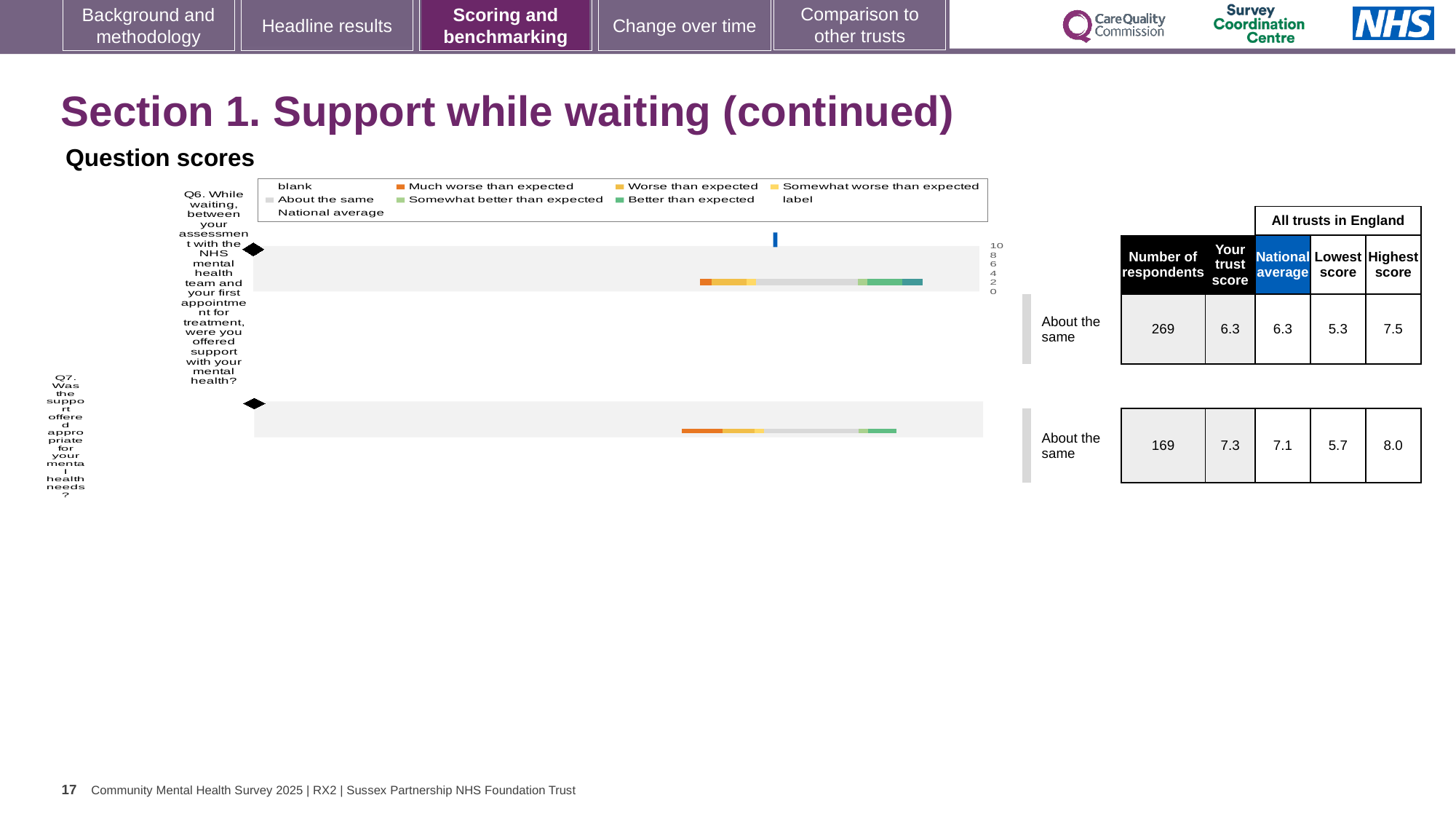
In the table next to the chart, which question has the higher 'Your trust score', Q6 or Q7? Q7 What is the highest tick value shown on the chart's score axis? 10 What kind of chart is shown under 'Question scores'? bar chart In the table next to the chart, what is the highest score across all trusts in England for Q7? 8.0 In the table next to the chart, what is the lowest score across all trusts in England for Q7? 5.7 In the table next to the chart, what is 'Your trust score' for Q7? 7.3 In the table next to the chart, what is the number of respondents for Q6? 269 In the table next to the chart, what is the national average for Q6? 6.3 How many entries does the chart legend list? 9 In the table next to the chart, what is the difference between the highest and lowest score for Q6? 2.2 How many questions (bars) are plotted in the chart? 2 What colour represents 'Much worse than expected' in the chart legend? orange